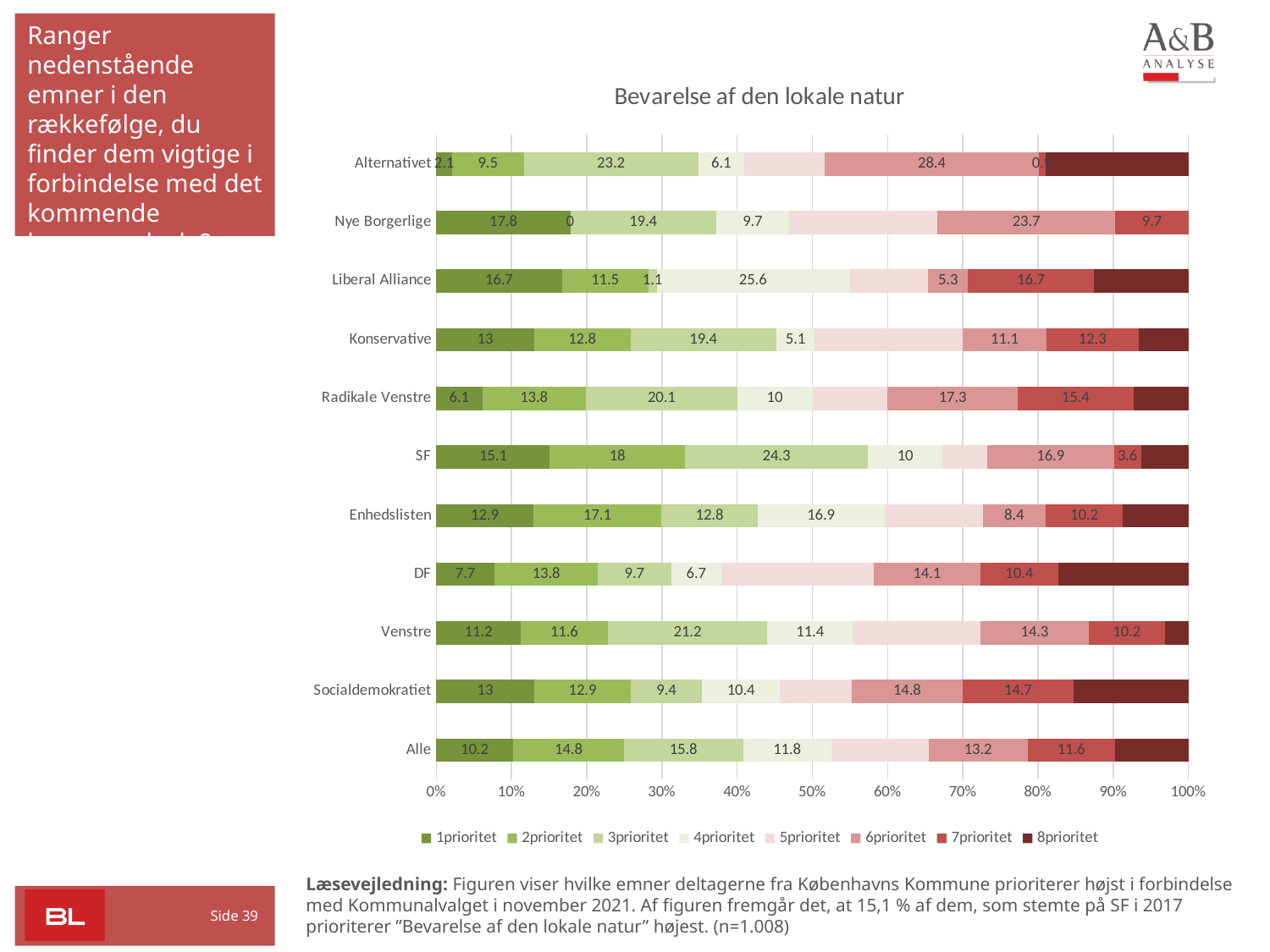
Which category has the lowest 1prioritet value? Alternativet What type of chart is shown on the slide? Stacked bar chart What is the title of the chart? Bevarelse af den lokale natur How many categories (rows) are shown on the y axis of the chart? 11 What is the difference between the 3prioritet values for SF and Alle? 8.5 Which is larger: the 4prioritet value for Liberal Alliance or for Enhedslisten? Liberal Alliance How many series does the legend list? 8 What is the 1prioritet value for SF? 15.1 What is the 6prioritet value for Alternativet? 28.4 Which category has the highest 1prioritet value? Nye Borgerlige What is the 3prioritet value for Venstre? 21.2 What is the 2prioritet value for Nye Borgerlige? 0